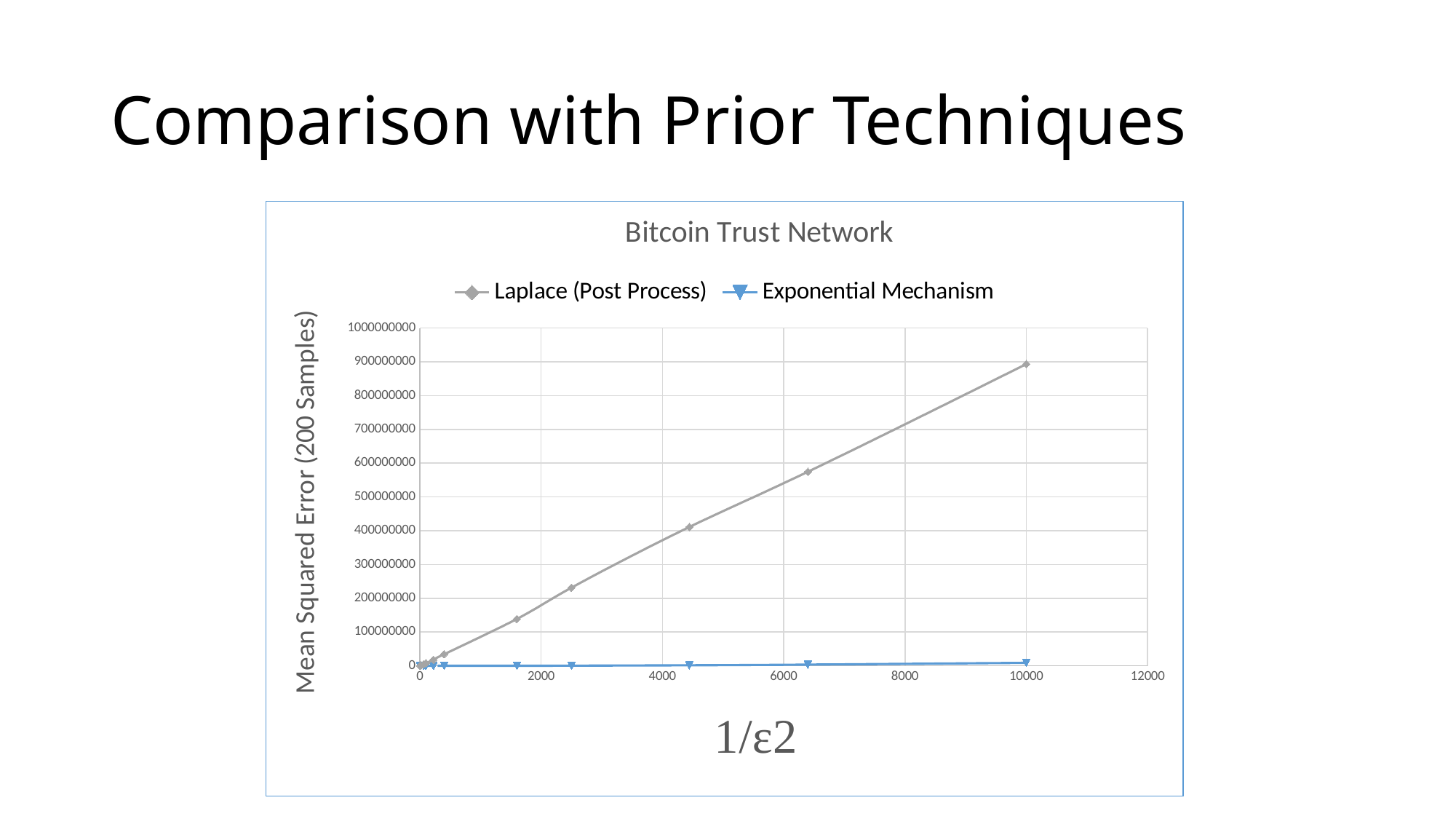
Which series has the higher mean squared error at 1/ε2 = 10000, Laplace (Post Process) or Exponential Mechanism? Laplace (Post Process) What kind of chart is shown on the slide? line chart Is the value for Laplace (Post Process) at 1/ε2 = 10000 greater or less than 800000000? greater Which series stays lowest across the whole range of 1/ε2? Exponential Mechanism What is the title of the chart? Bitcoin Trust Network Does the mean squared error for Laplace (Post Process) rise or fall as 1/ε2 increases? rise Is the value for Exponential Mechanism at 1/ε2 = 10000 greater or less than 100000000? less How many series does the legend list? 2 Is the value for Laplace (Post Process) at 1/ε2 = 6400 greater or less than 500000000? greater What is the label of the y axis? Mean Squared Error (200 Samples)